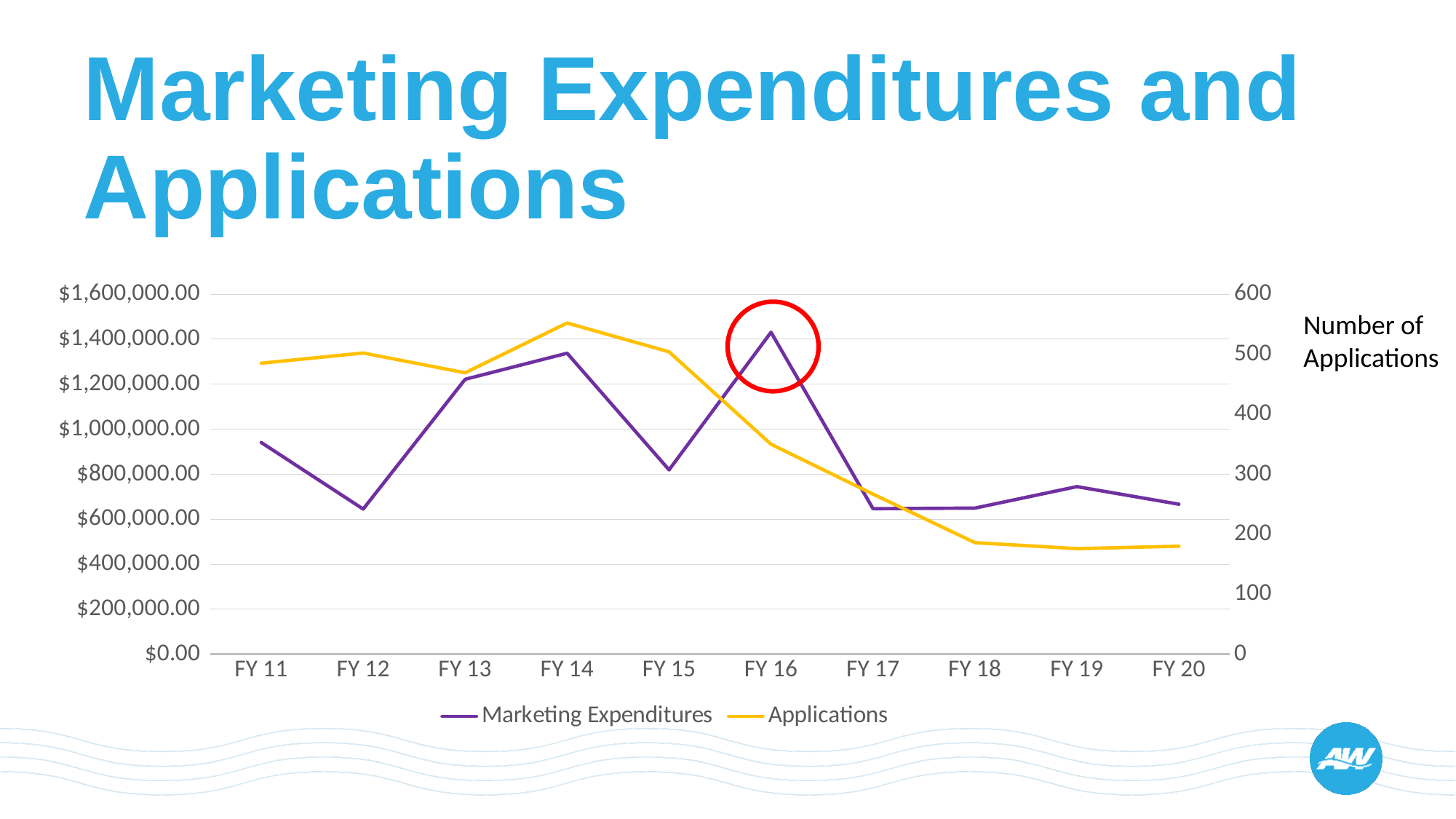
Do Applications rise or fall from FY 14 to FY 19? fall Which is larger, Marketing Expenditures in FY 13 or in FY 12? FY 13 Is the value for Applications in FY 14 greater or less than 500? greater How many fiscal years are plotted along the x axis? 10 Is the value for Marketing Expenditures in FY 12 greater or less than $800,000.00? less Is the value for Marketing Expenditures in FY 16 greater or less than $1,200,000.00? greater Which fiscal year's Marketing Expenditures point is circled in red? FY 16 In which fiscal year is the number of Applications highest? FY 14 In which fiscal year are Marketing Expenditures highest? FY 16 What kind of chart is shown on the slide? line chart How many series does the legend list? 2